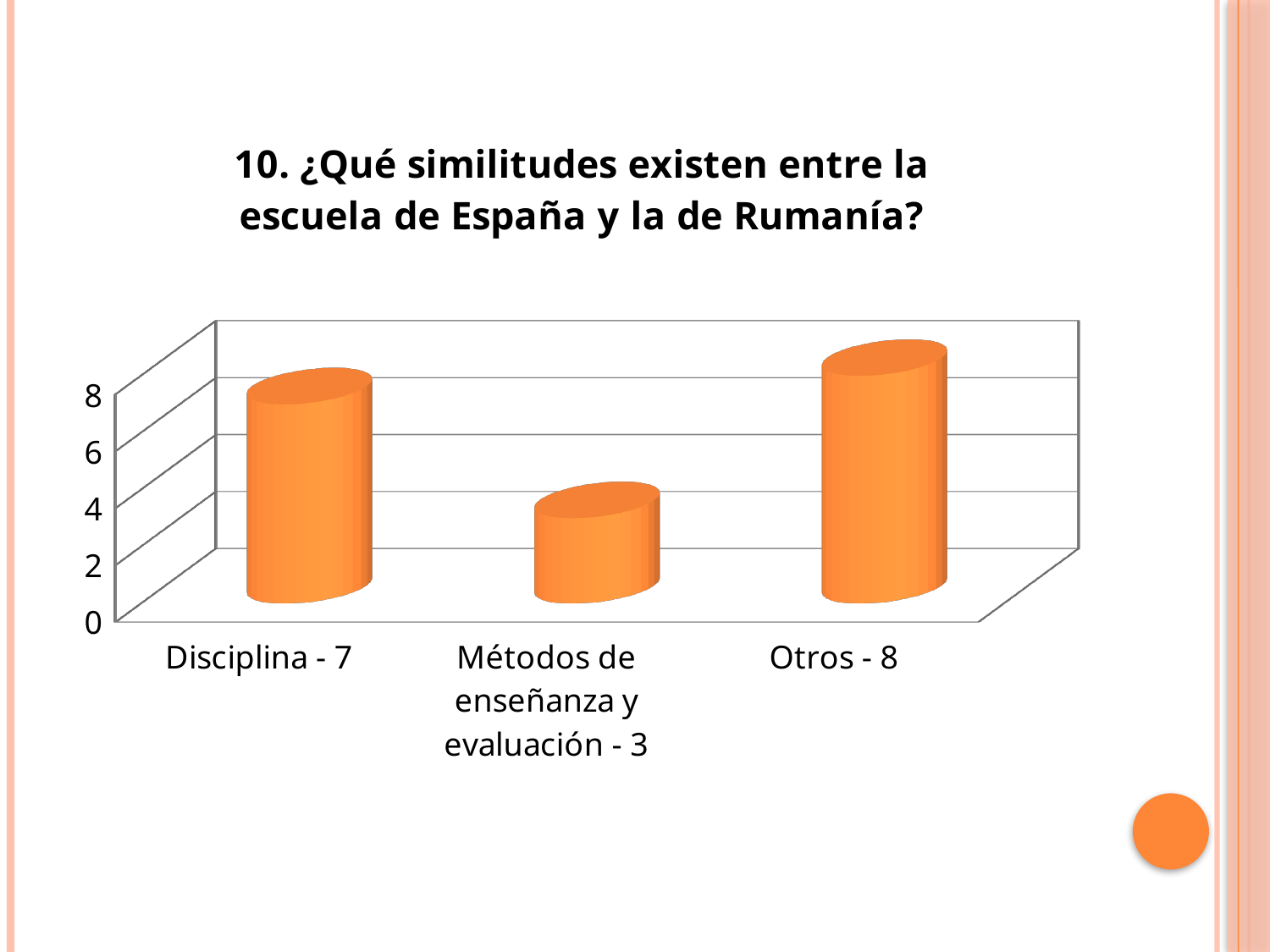
Which is larger, the value for Disciplina or the value for Métodos de enseñanza y evaluación? Disciplina Is the value for Métodos de enseñanza y evaluación greater or less than 4? less What is the difference between the values for Disciplina and Métodos de enseñanza y evaluación? 4 What is the difference between the values for Otros and Disciplina? 1 What value is shown for Disciplina? 7 Which category has the lowest value? Métodos de enseñanza y evaluación How many categories are shown in the chart? 3 What kind of chart is shown on the slide? bar chart What is the title of the chart? 10. ¿Qué similitudes existen entre la escuela de España y la de Rumanía? What value is shown for Métodos de enseñanza y evaluación? 3 Which category has the highest value? Otros What value is shown for Otros? 8